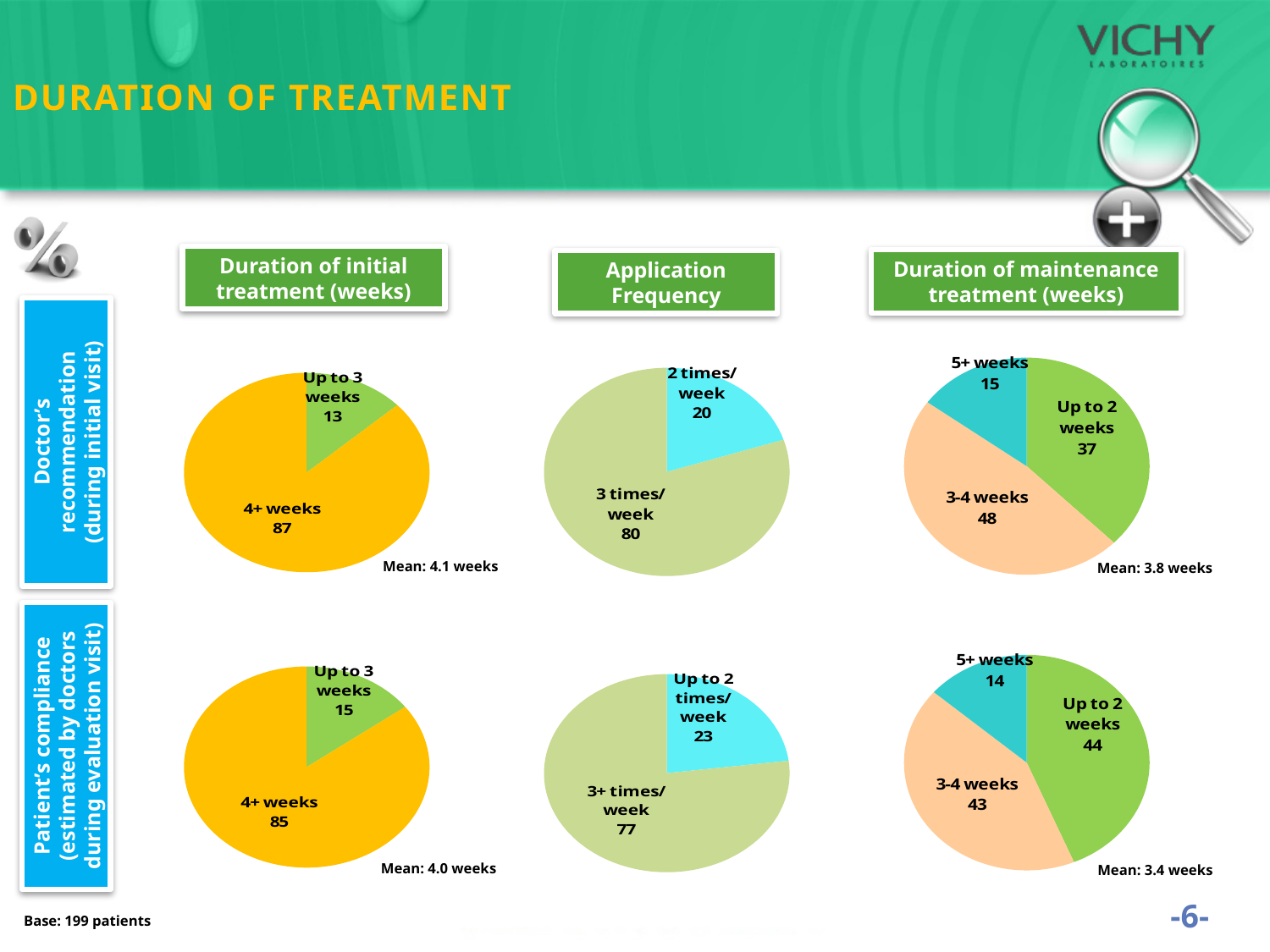
In the Patient's compliance pie chart for Application Frequency (bottom middle), what is the value for 3+ times/week? 77 In the Doctor's recommendation pie chart for Duration of initial treatment (top left), which is larger: Up to 3 weeks or 4+ weeks? 4+ weeks In the Doctor's recommendation pie chart for Duration of initial treatment (top left), what is the value for 4+ weeks? 87 What mean is printed below the Patient's compliance pie chart for Duration of maintenance treatment (bottom right)? Mean: 3.4 weeks In the Patient's compliance pie chart for Duration of maintenance treatment (bottom right), which category has the smallest slice? 5+ weeks In the Doctor's recommendation pie chart for Duration of maintenance treatment (top right), which category has the largest slice? 3-4 weeks What kind of chart is used for the Doctor's recommendation Duration of initial treatment data (top left)? Pie chart In the Doctor's recommendation pie chart for Duration of maintenance treatment (top right), what is the difference between the 3-4 weeks value and the Up to 2 weeks value? 11 What mean is printed below the Doctor's recommendation pie chart for Duration of initial treatment (top left)? Mean: 4.1 weeks In the Doctor's recommendation pie chart for Application Frequency (top middle), what is the value for 2 times/week? 20 In the Patient's compliance pie chart for Duration of initial treatment (bottom left), what is the value for Up to 3 weeks? 15 In the Patient's compliance pie chart for Duration of maintenance treatment (bottom right), how many categories are shown? 3